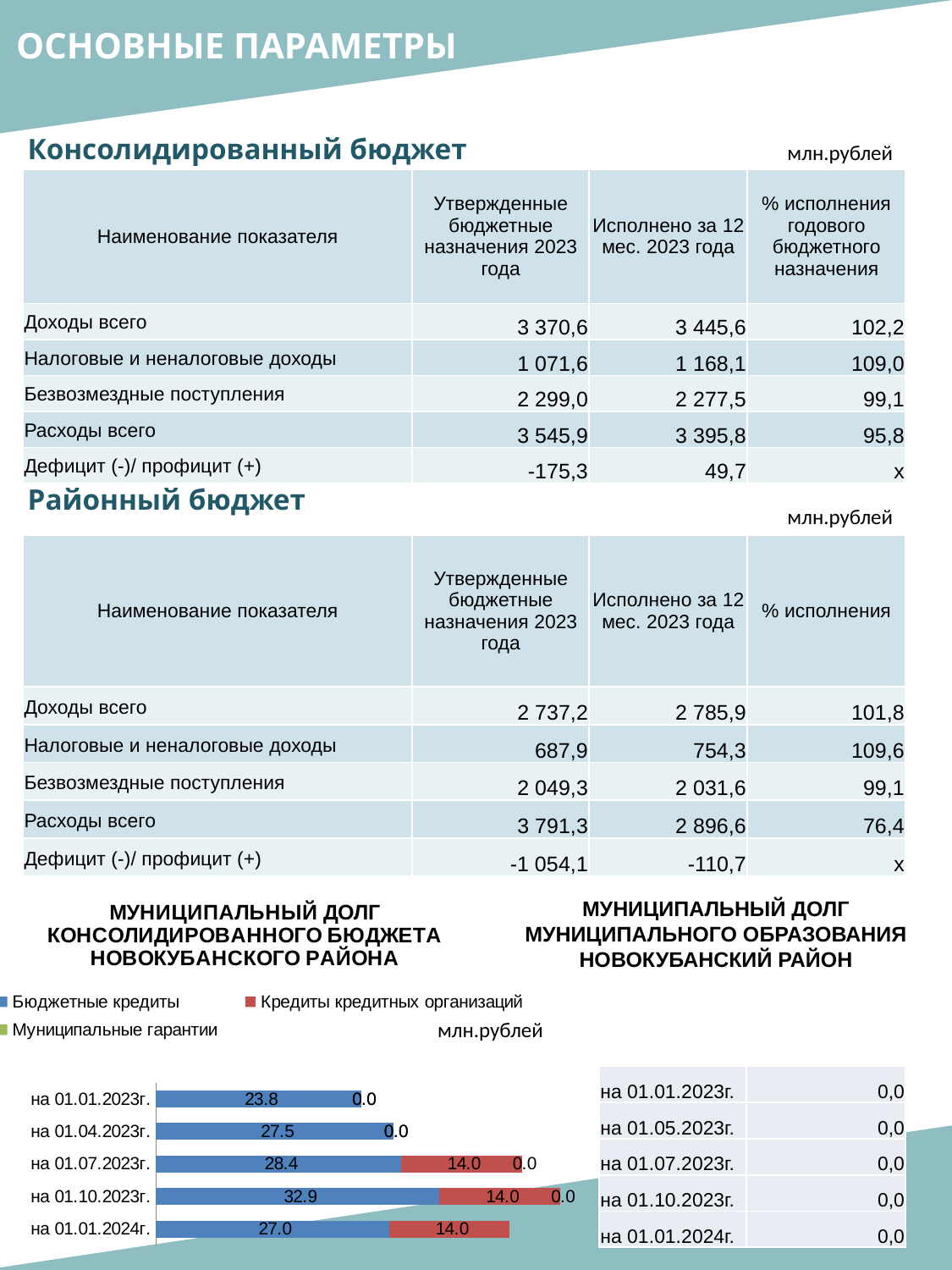
How many dates (categories) are shown in the municipal debt chart? 5 In the municipal debt chart, what is the value of Бюджетные кредиты on 01.01.2024г.? 27.0 In the municipal debt chart, what is the total of the stacked bar for 01.10.2023г.? 46.9 In the municipal debt chart, on which date is the value of Бюджетные кредиты lowest? на 01.01.2023г. In the municipal debt chart, on which date is the value of Бюджетные кредиты highest? на 01.10.2023г. What kind of chart is the municipal debt chart at the bottom left of the slide? bar chart In the municipal debt chart, what is the difference between Бюджетные кредиты on 01.10.2023г. and on 01.01.2023г.? 9.1 In the municipal debt chart, which is larger: Бюджетные кредиты on 01.04.2023г. or on 01.07.2023г.? на 01.07.2023г. In the municipal debt chart, what is the value of Бюджетные кредиты on 01.01.2023г.? 23.8 How many series does the legend of the municipal debt chart list? 3 In the municipal debt chart, what is the value of Кредиты кредитных организаций on 01.07.2023г.? 14.0 In the municipal debt chart, what is the value of Бюджетные кредиты on 01.10.2023г.? 32.9